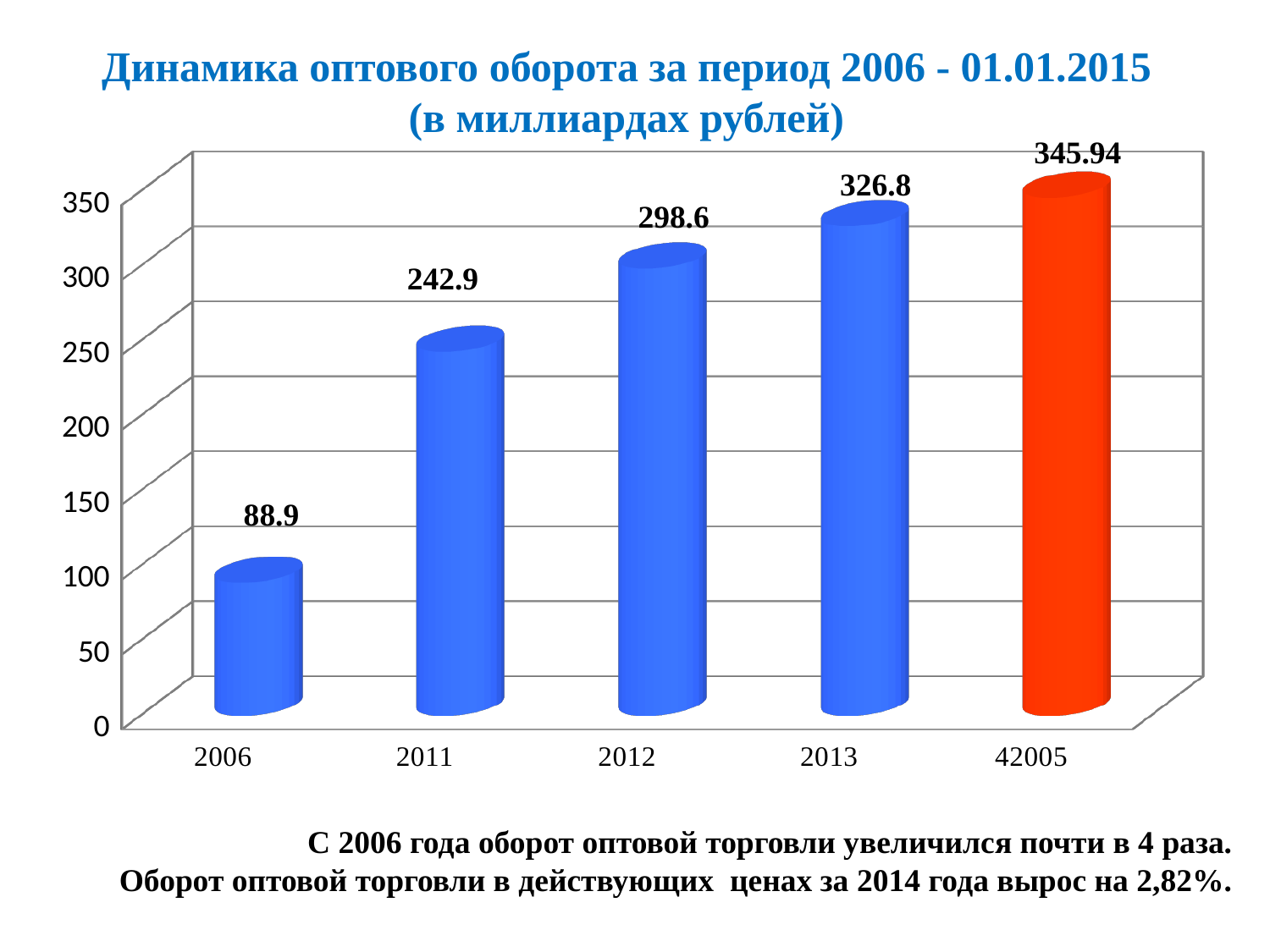
Which is larger, the value for 2011 or the value for 2012? 2012 What is the difference between the values for 2012 and 2011? 55.7 What kind of chart is shown on the slide? bar chart How many categories are shown on the x axis? 5 What is the difference between the values for 2013 and 2006? 237.9 Do the values rise or fall from left to right along the x axis? rise Which category has the lowest value? 2006 What is the value for 2013? 326.8 What is the value for the category labelled 42005? 345.94 Is the value for 2011 greater or less than 200? greater Which category has the highest value? 42005 What is the value for 2006? 88.9